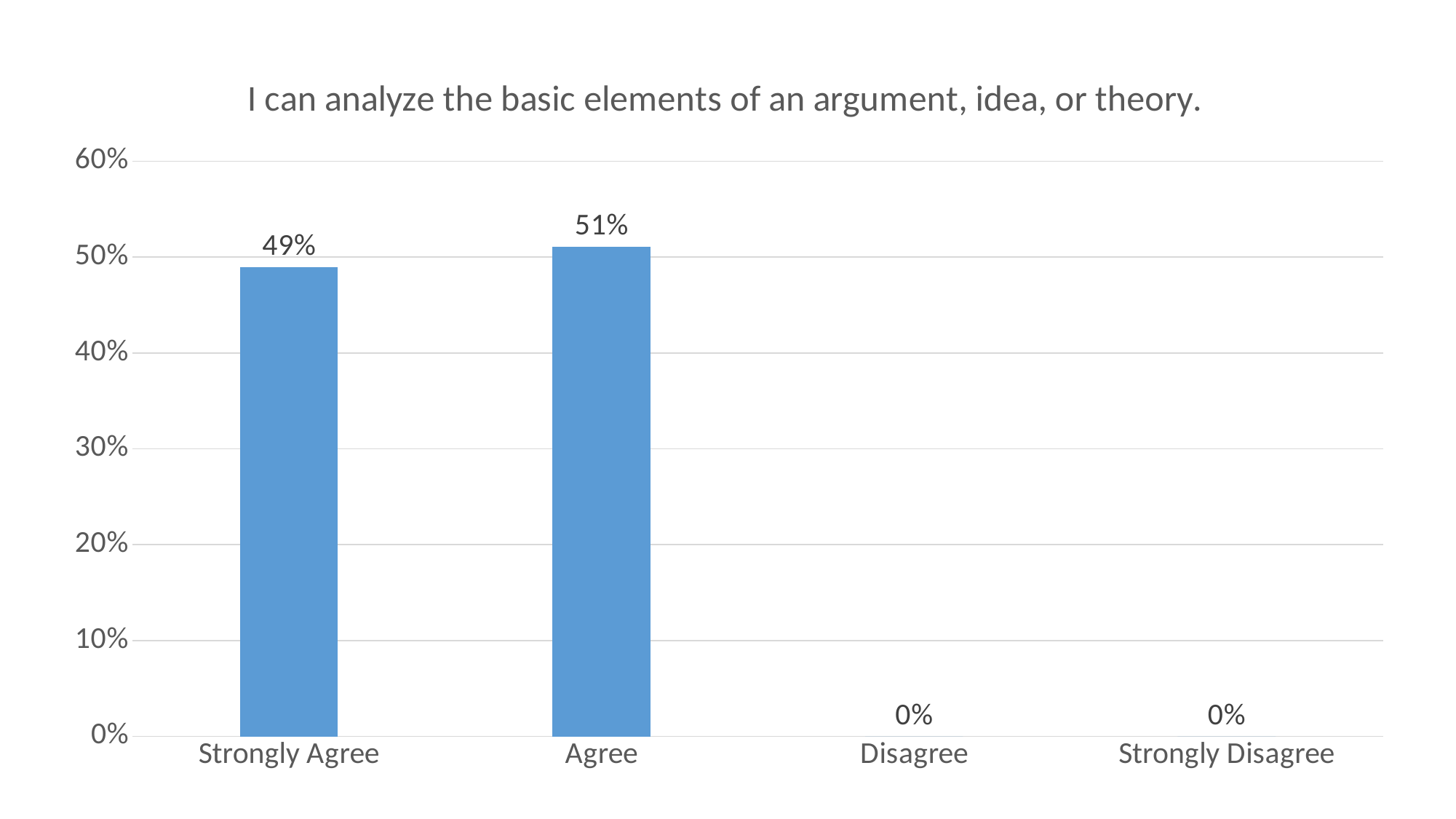
Is the value for Strongly Agree greater or less than 40%? greater What kind of chart is shown on the slide? bar chart What percentage of respondents chose Strongly Agree? 49% What is the value shown for Disagree? 0% How many response categories are shown on the x axis? 4 What is the highest value labelled on the vertical axis? 60% What is the value shown for Strongly Disagree? 0% Which response category has the highest value? Agree Which is larger, the value for Strongly Agree or the value for Agree? Agree What percentage of respondents chose Agree? 51% What is the difference between the Agree and Strongly Agree values? 2% What is the title of the chart? I can analyze the basic elements of an argument, idea, or theory.